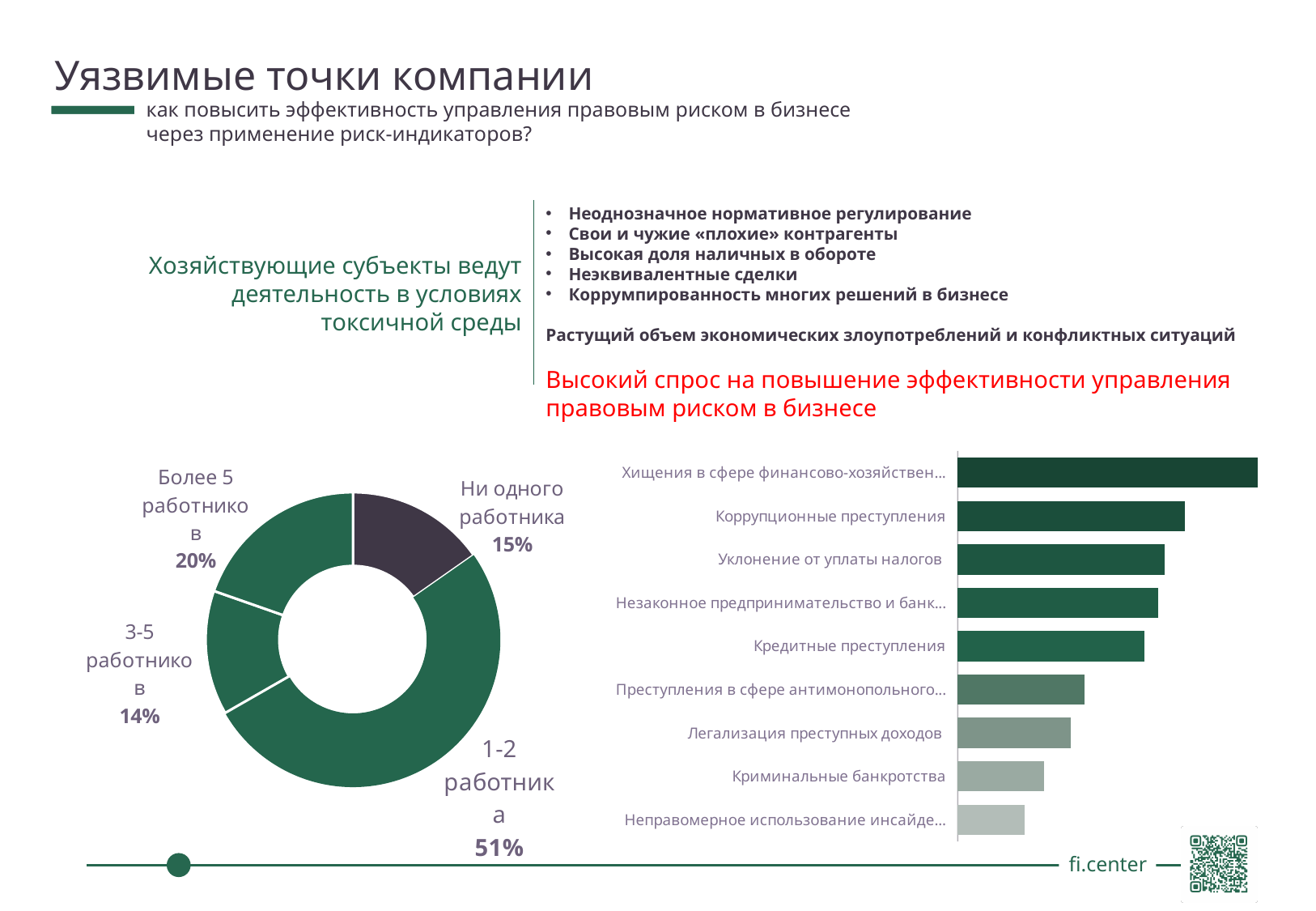
In the donut chart on the left, which category has the largest share? 1-2 работника What kind of chart is shown on the left of the slide? Donut chart In the donut chart on the left, what share is shown for "3-5 работников"? 14% In the bar chart on the right, which category has the longest bar? Хищения в сфере финансово-хозяйствен... In the donut chart on the left, what share is shown for "1-2 работника"? 51% In the donut chart on the left, what share is shown for "Ни одного работника"? 15% In the bar chart on the right, which category has the shortest bar? Неправомерное использование инсайде... How many categories does the donut chart on the left show? 4 In the donut chart on the left, which is larger: the share for "Более 5 работников" or for "Ни одного работника"? Более 5 работников In the donut chart on the left, which category has the smallest share? 3-5 работников What kind of chart is shown on the right of the slide? Bar chart In the donut chart on the left, what is the difference in percentage points between "Более 5 работников" and "3-5 работников"? 6